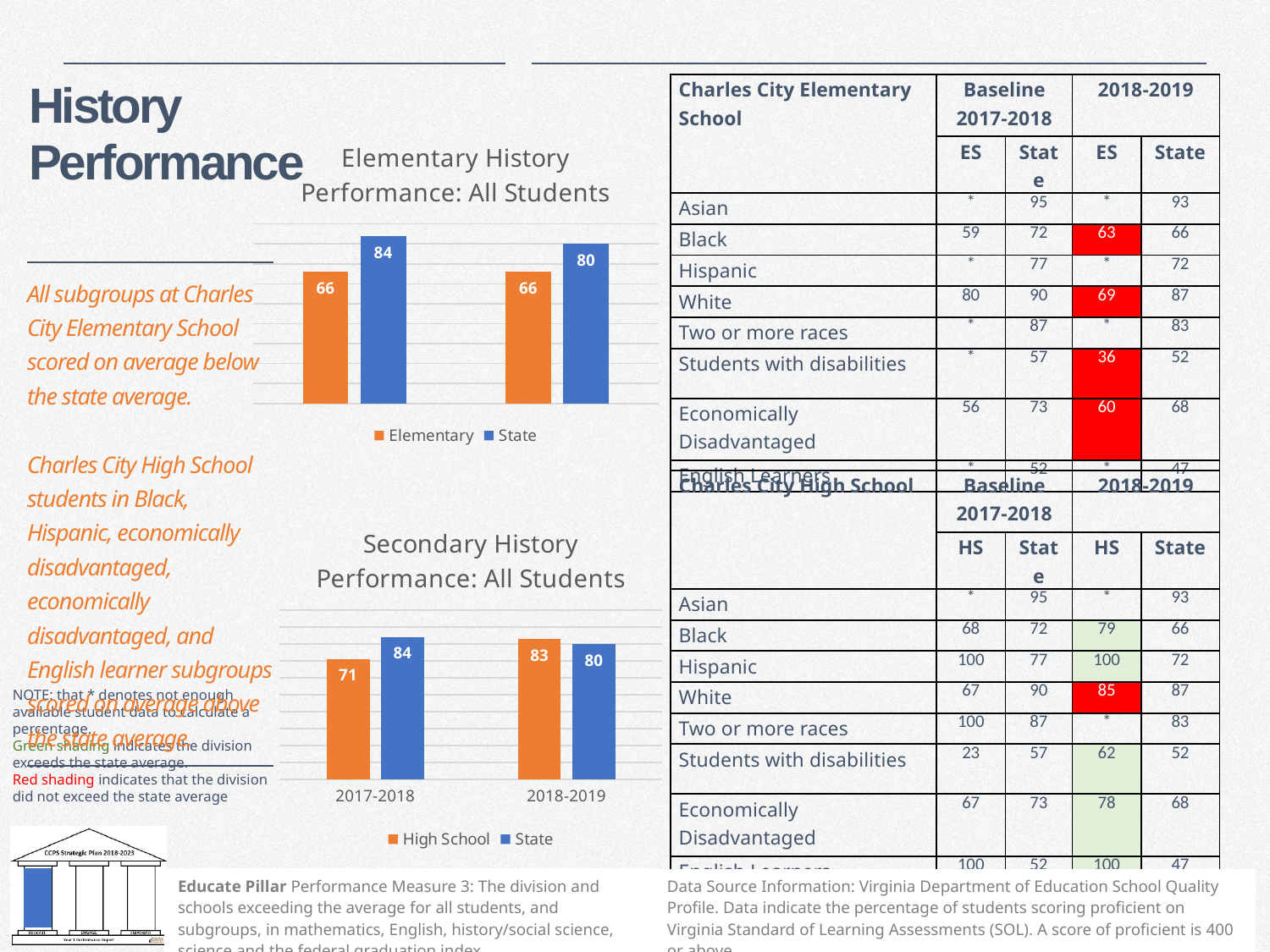
In the Secondary History Performance: All Students chart, what is the State value for 2018-2019? 80 In the Secondary History Performance: All Students chart, what is the High School value for 2017-2018? 71 What kind of chart is the Elementary History Performance: All Students chart? bar chart In the Secondary History Performance: All Students chart, what is the High School value for 2018-2019? 83 In the Secondary History Performance: All Students chart, does the High School value rise or fall from 2017-2018 to 2018-2019? rise In the Elementary History Performance: All Students chart, what is the Elementary value in the left group of bars? 66 In the Elementary History Performance: All Students chart, what is the difference between the State and Elementary values in the left group of bars? 18 In the Elementary History Performance: All Students chart, which series is shown in orange? Elementary In the Secondary History Performance: All Students chart, which is larger for 2018-2019, High School or State? High School In the Secondary History Performance: All Students chart, what is the difference between the State and High School values for 2017-2018? 13 How many series does the legend of the Secondary History Performance: All Students chart list? 2 In the Elementary History Performance: All Students chart, what is the State value in the right group of bars? 80